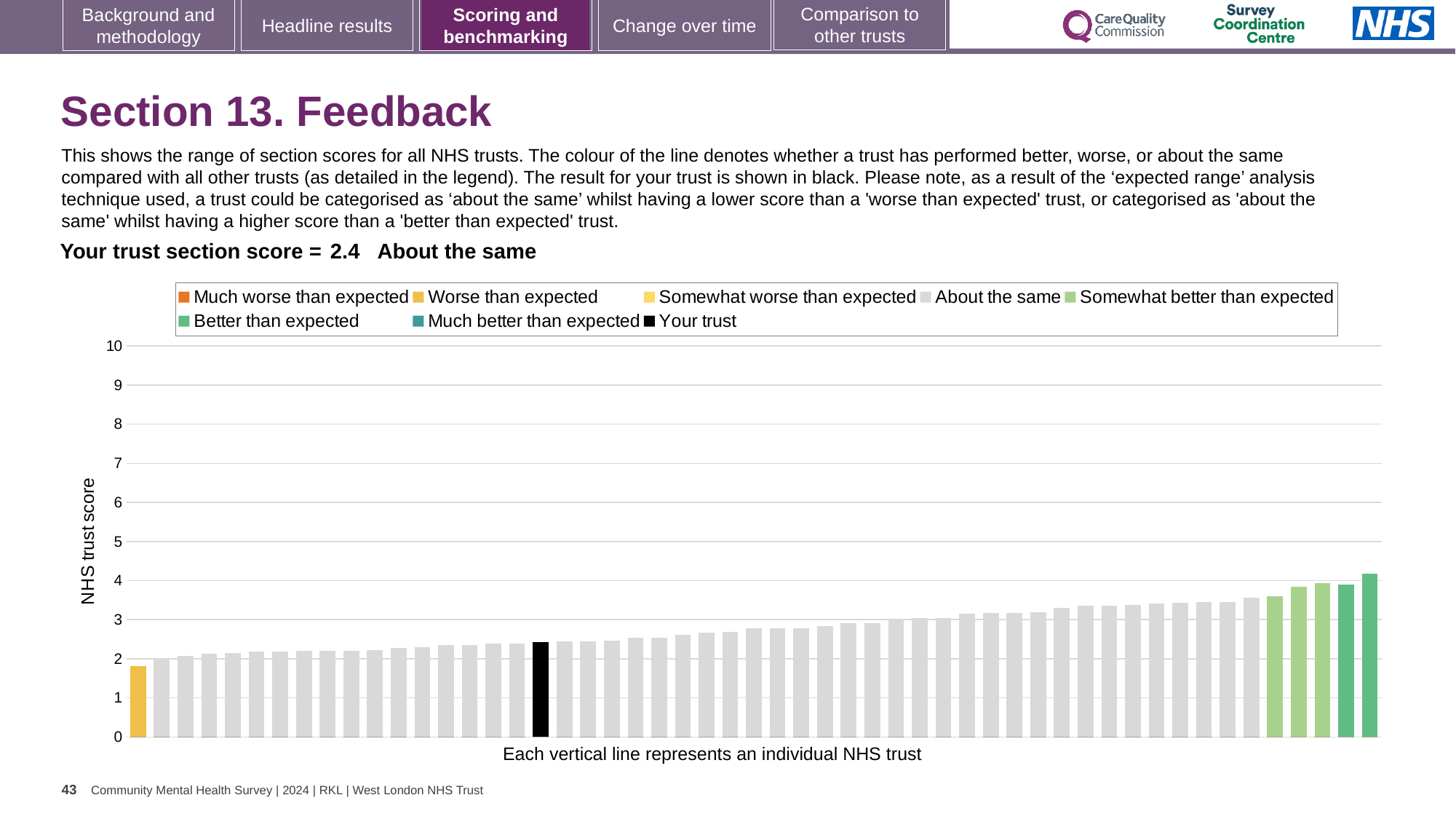
Is the value of the highest bar (the rightmost trust) greater or less than 4? greater Is the value for your trust (the black bar) greater or less than 2? greater What is the label on the y axis of the chart? NHS trust score Which is larger: the value of the black bar (your trust) or the value of the yellow bar at the far left? the black bar (your trust) According to the legend, which colour represents your trust? black Do the bar values rise or fall moving from left to right along the x axis? rise How many entries does the chart legend list? 8 Is the value for your trust (the black bar) greater or less than 3? less What kind of chart is shown on the slide? bar chart What is the section score for your trust shown on the slide? 2.4 What is the highest value shown on the y axis? 10